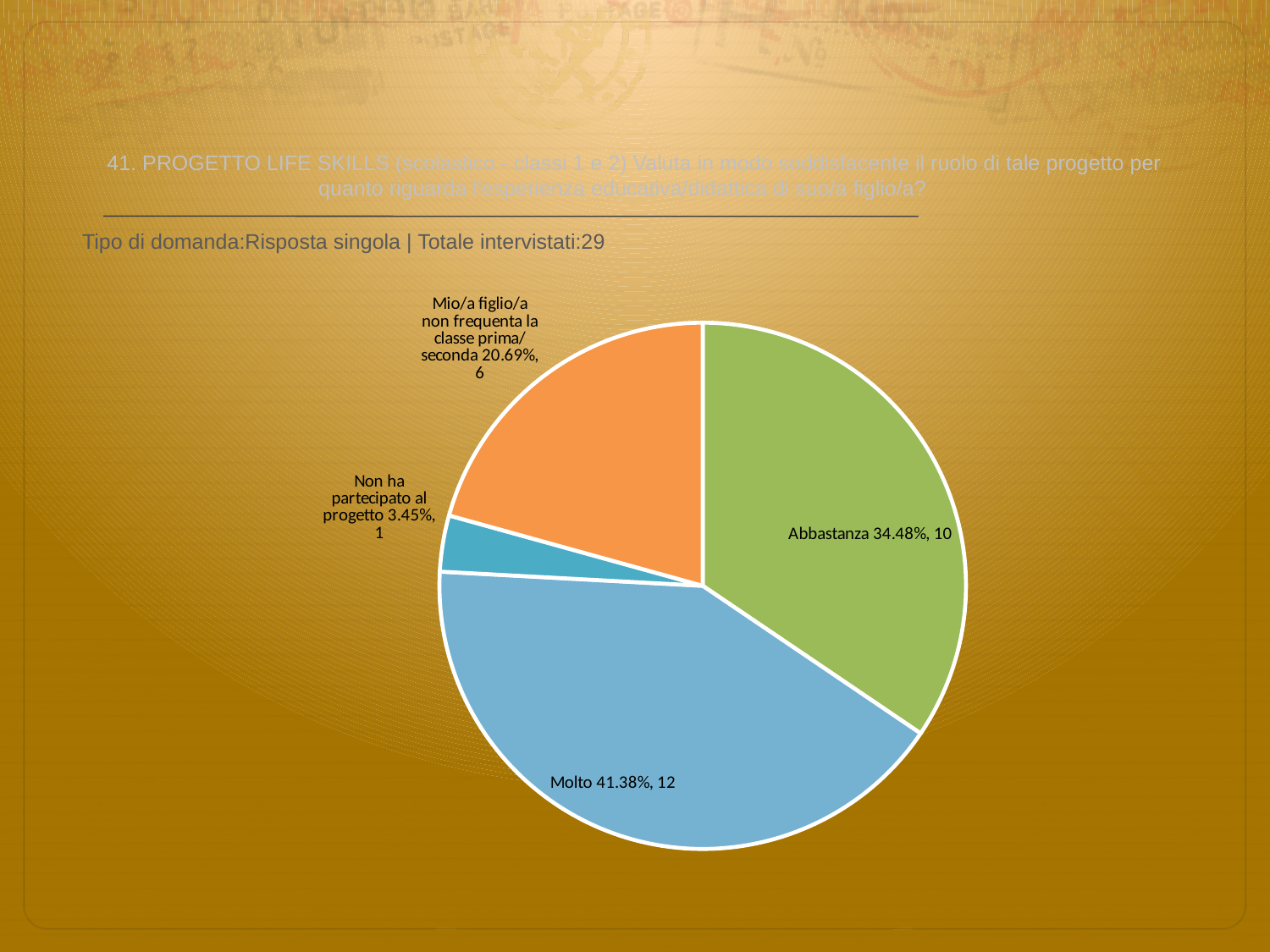
How many respondents answered 'Abbastanza'? 10 What percentage share does the 'Abbastanza' slice have? 34.48% How many respondents answered 'Non ha partecipato al progetto'? 1 What percentage share does the 'Molto' slice have? 41.38% What is the difference in respondent count between 'Molto' and 'Abbastanza'? 2 What kind of chart is shown on the slide? pie chart How many slices does the pie chart have? 4 What colour is the 'Molto' slice? blue Which category has the largest slice? Molto Which has more respondents, 'Abbastanza' or 'Mio/a figlio/a non frequenta la classe prima/seconda'? Abbastanza What percentage share does the 'Mio/a figlio/a non frequenta la classe prima/seconda' slice have? 20.69% Which category has the smallest slice? Non ha partecipato al progetto